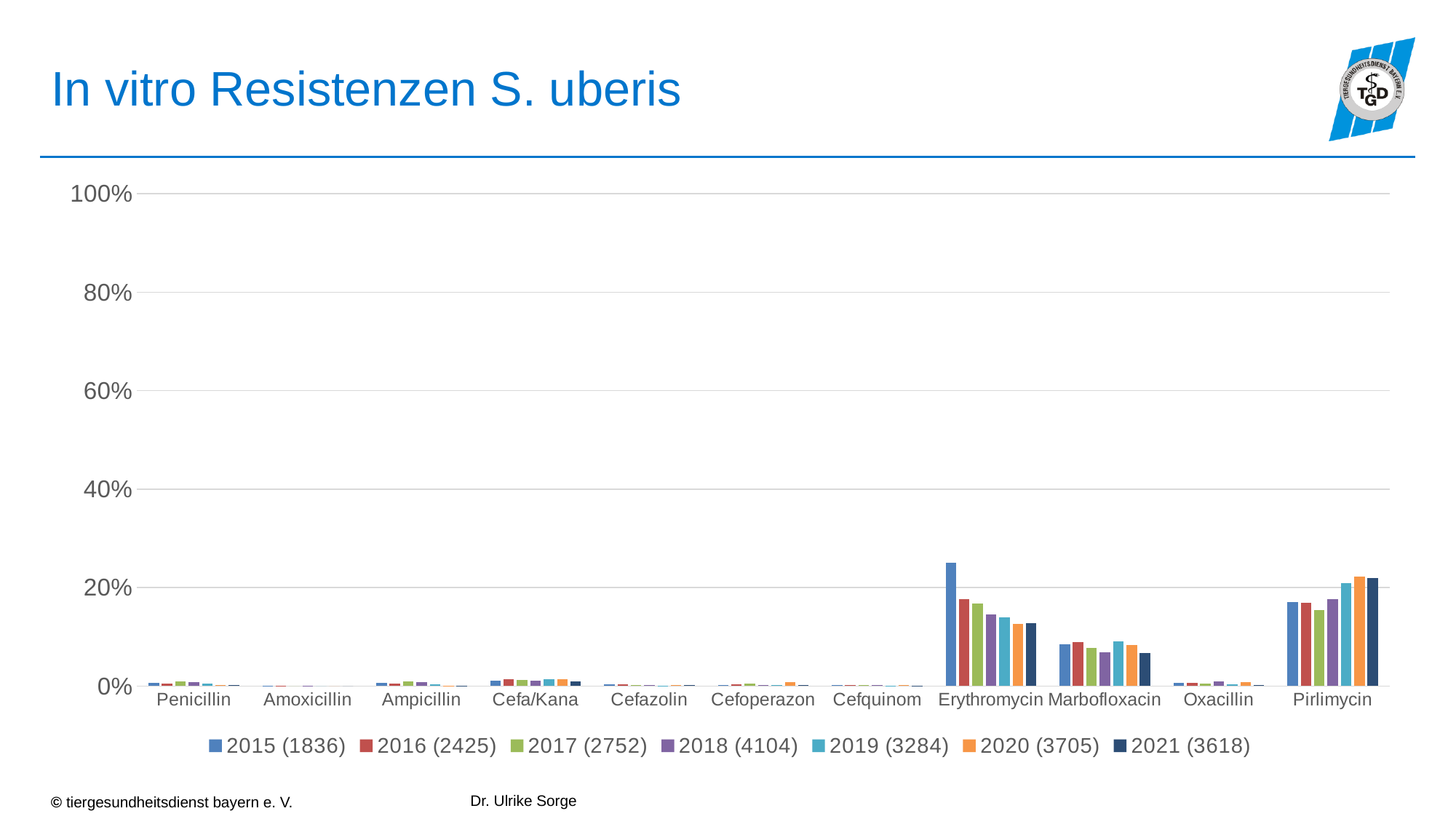
Which antibiotic has the highest value for 2021: Erythromycin or Pirlimycin? Pirlimycin Is the 2015 value for Erythromycin greater or less than 20%? greater How many antibiotic categories are shown on the x axis? 11 What is the title of the slide? In vitro Resistenzen S. uberis Is the 2020 value for Pirlimycin greater or less than 20%? greater Which series has the highest value for Erythromycin? 2015 (1836) Which is larger for 2015: the value for Erythromycin or the value for Pirlimycin? Erythromycin Is the 2021 value for Marbofloxacin greater or less than 20%? less Which antibiotic has the tallest bar in the chart? Erythromycin How many series does the legend list? 7 Do the Erythromycin values rise or fall from 2015 to 2021? fall What kind of chart is shown on the slide? bar chart